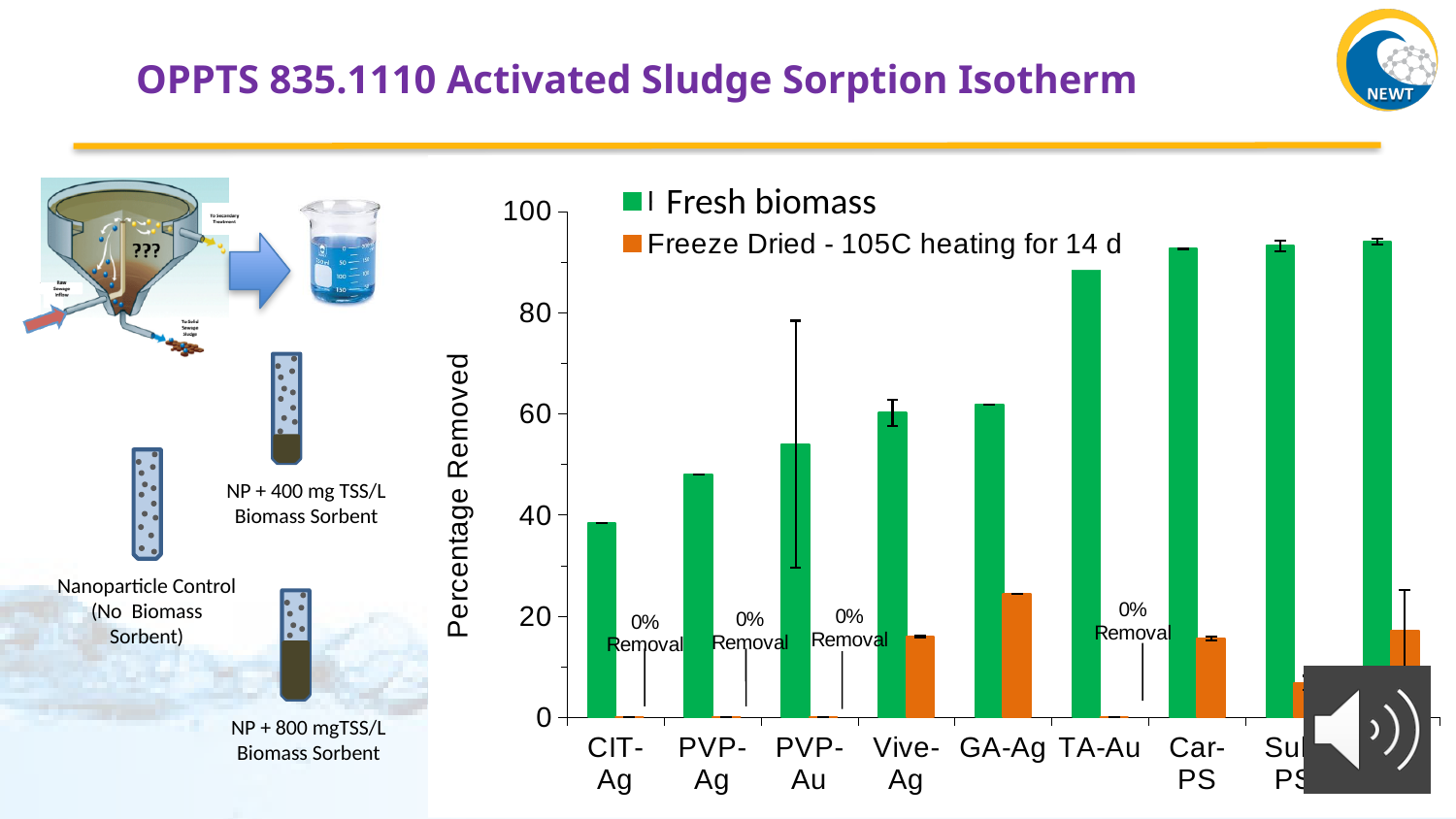
What is the label of the y axis of the chart? Percentage Removed What type of chart is shown on the slide? bar chart How many categories are annotated with "0% Removal" in the chart? 4 Is the Fresh biomass value for PVP-Ag greater or less than 60? less Is the Fresh biomass value for TA-Au greater or less than 80? greater Which series is shown in orange in the chart? Freeze Dried - 105C heating for 14 d What is the Freeze Dried removal value for TA-Au? 0% Do the Fresh biomass values generally rise or fall from CIT-Ag to Car-PS along the x axis? rise What is the Freeze Dried removal value for CIT-Ag? 0% For Vive-Ag, which series has the larger value, Fresh biomass or Freeze Dried? Fresh biomass How many series does the chart legend list? 2 Which category has the lowest Fresh biomass value? CIT-Ag